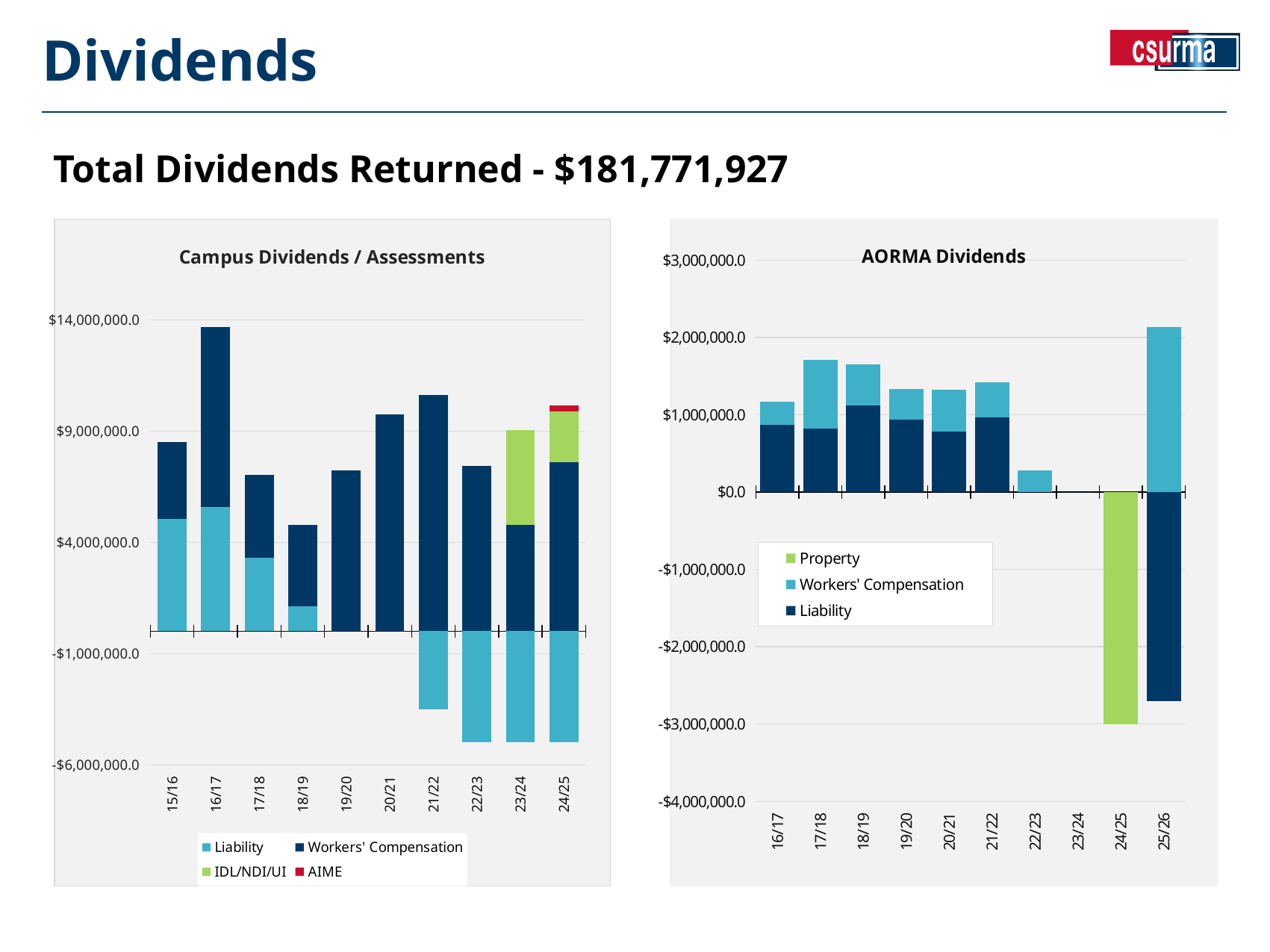
In the AORMA Dividends chart, is the Property value for 24/25 greater or less than -$2,000,000? less How many series does the legend of the AORMA Dividends chart list? 3 In the Campus Dividends / Assessments chart, which year has the tallest Workers' Compensation bar? 21/22 How many fiscal years are shown on the x axis of the Campus Dividends / Assessments chart? 10 In the Campus Dividends / Assessments chart, is the Liability value for 22/23 greater or less than -$1,000,000? less How many series does the legend of the Campus Dividends / Assessments chart list? 4 In the AORMA Dividends chart, is the Workers' Compensation value for 25/26 greater or less than $1,000,000? greater In the Campus Dividends / Assessments chart, which series is shown in green? IDL/NDI/UI In the AORMA Dividends chart, which year has the highest Liability value? 18/19 How many fiscal years are shown on the x axis of the AORMA Dividends chart? 10 What type of chart is the Campus Dividends / Assessments chart? Stacked bar chart